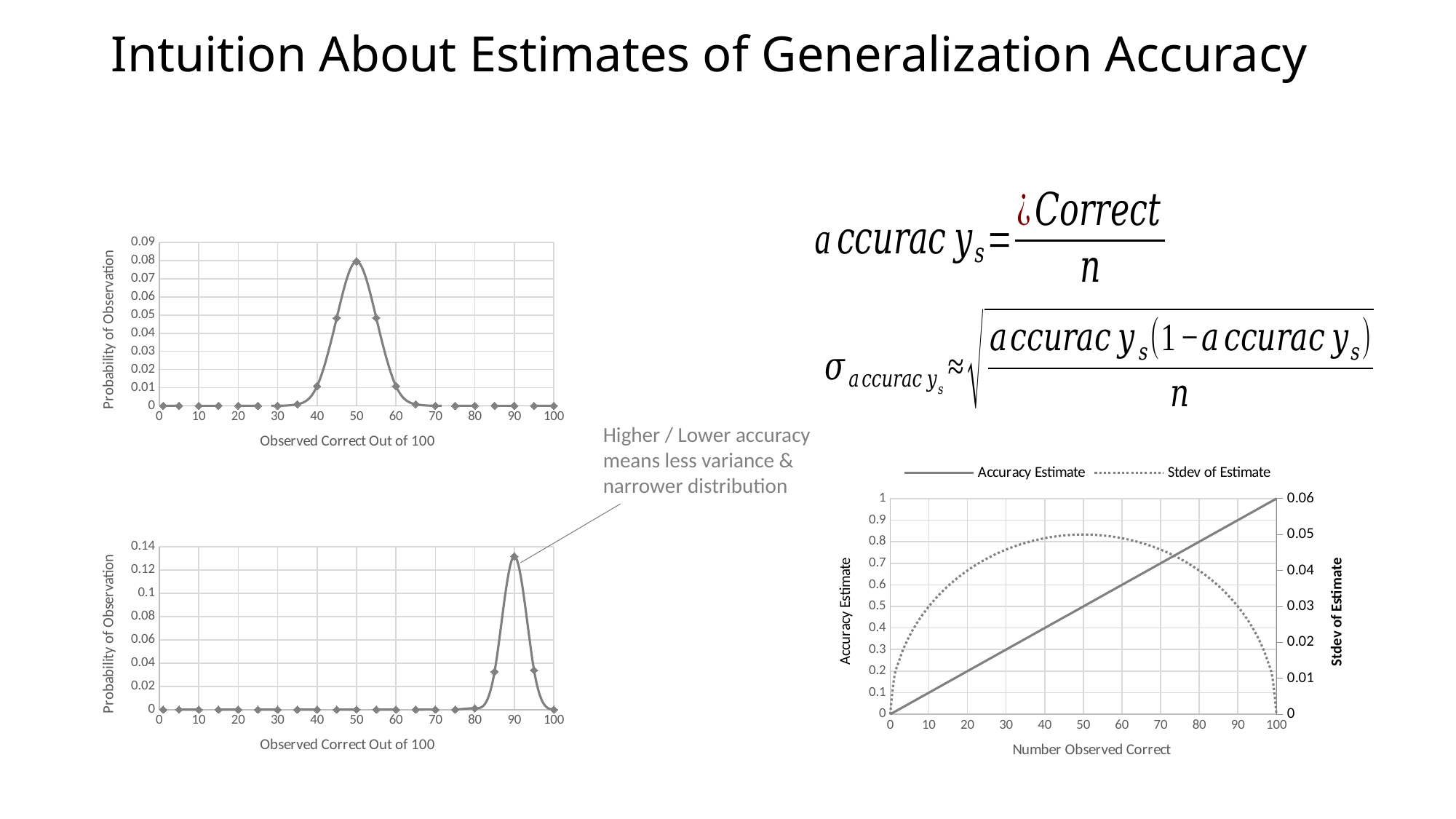
In the right-hand chart, how many series does the legend list? 2 In the right-hand chart, what is the Accuracy Estimate when the Number Observed Correct is 100? 1 In the bottom-left chart, is the Probability of Observation at 90 observed correct greater or less than 0.1? greater In the bottom-left chart, at which value of Observed Correct Out of 100 is the Probability of Observation highest? 90 What kind of chart is the top-left chart on the slide? line chart What is the x-axis title of the right-hand chart? Number Observed Correct In the right-hand chart, what are the two series named in the legend? Accuracy Estimate and Stdev of Estimate In the right-hand chart, what is the Accuracy Estimate when the Number Observed Correct is 50? 0.5 In the top-left chart, is the Probability of Observation at 50 observed correct greater or less than 0.05? greater In the right-hand chart, what is the Stdev of Estimate when the Number Observed Correct is 50? 0.05 In the top-left chart, at which value of Observed Correct Out of 100 is the Probability of Observation highest? 50 In the right-hand chart, does the Accuracy Estimate rise or fall as the Number Observed Correct increases? rises